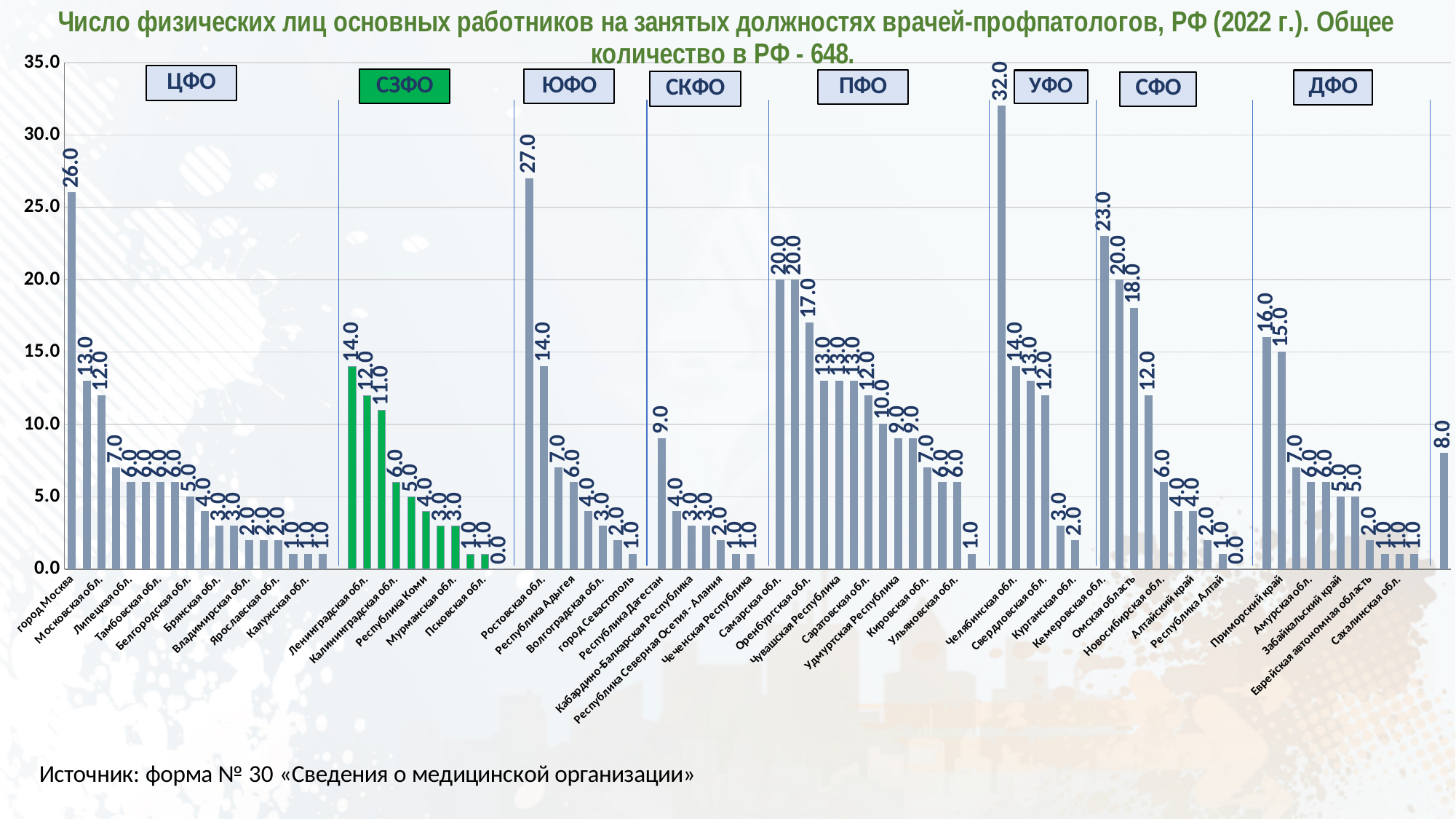
What is the value for Ростовская обл.? 14.0 What type of chart is shown on the slide? bar chart Which federal district group is highlighted in green on the chart? СЗФО Is the value for Республика Дагестан greater or less than 10.0? less How many federal district groups (ЦФО, СЗФО, etc.) are labelled on the chart? 8 What is the value for Ленинградская обл.? 12.0 Which is larger, the value for город Москва or the value for Ростовская обл.? город Москва What is the difference between the values for Челябинская обл. and Ростовская обл.? 0.0 What is the value for город Москва? 26.0 What is the value for Челябинская обл.? 14.0 What is the value for Кемеровская обл.? 23.0